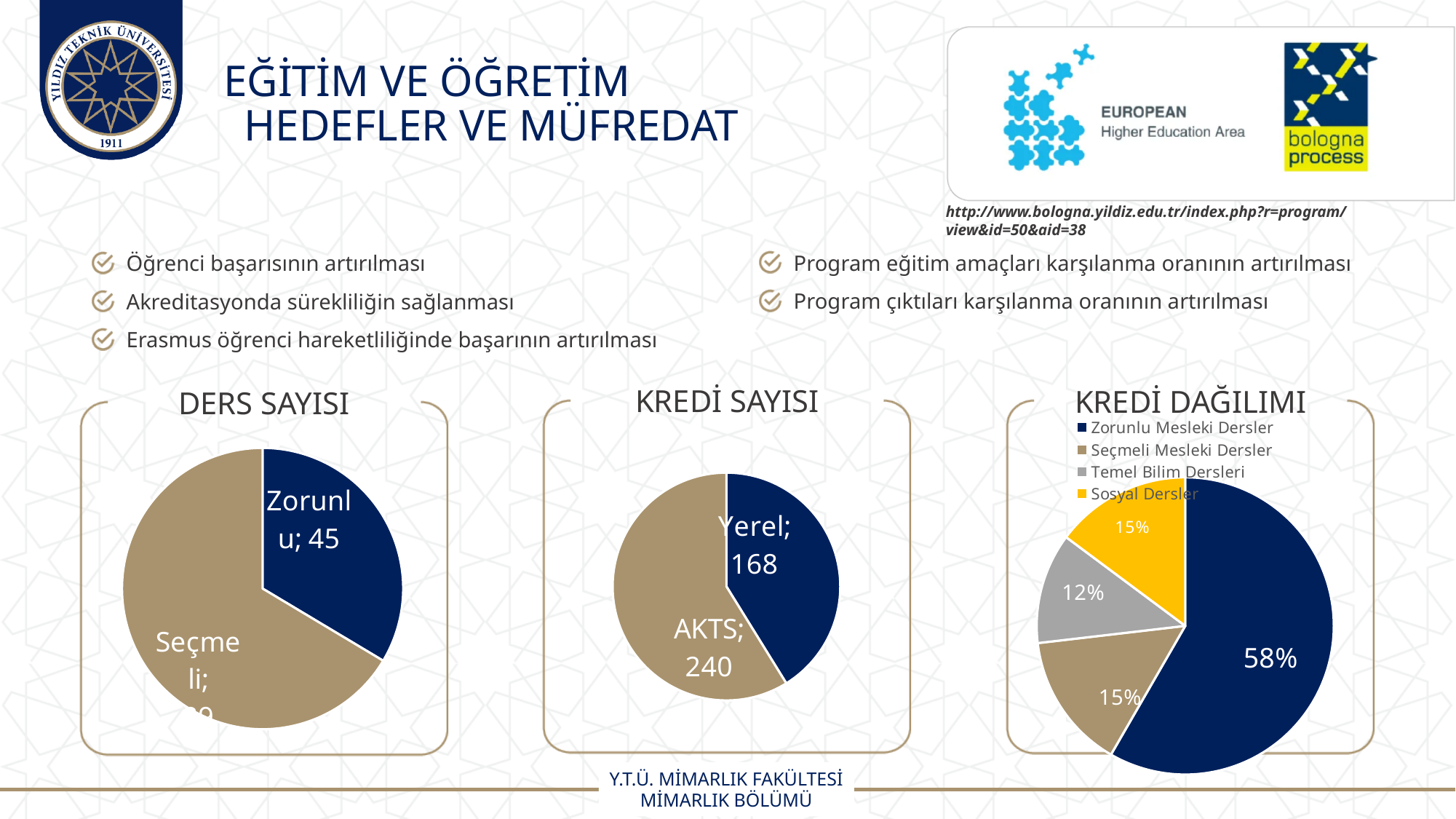
In the KREDİ SAYISI chart, what is the value for AKTS? 240 What type of chart is the DERS SAYISI chart? pie chart How many slices does the DERS SAYISI pie chart have? 2 In the KREDİ SAYISI chart, what is the difference between the AKTS and Yerel values? 72 In the KREDİ DAĞILIMI chart, which category has the smallest share? Temel Bilim Dersleri In the KREDİ SAYISI chart, what is the value for Yerel? 168 In the KREDİ DAĞILIMI chart, what share do Sosyal Dersler have? 15% In the DERS SAYISI chart, which slice is larger, Zorunlu or Seçmeli? Seçmeli How many entries does the legend of the KREDİ DAĞILIMI chart list? 4 In the KREDİ SAYISI chart, which is larger, Yerel or AKTS? AKTS In the KREDİ DAĞILIMI chart, what share do Zorunlu Mesleki Dersler have? 58% In the DERS SAYISI chart, what is the value for Zorunlu? 45